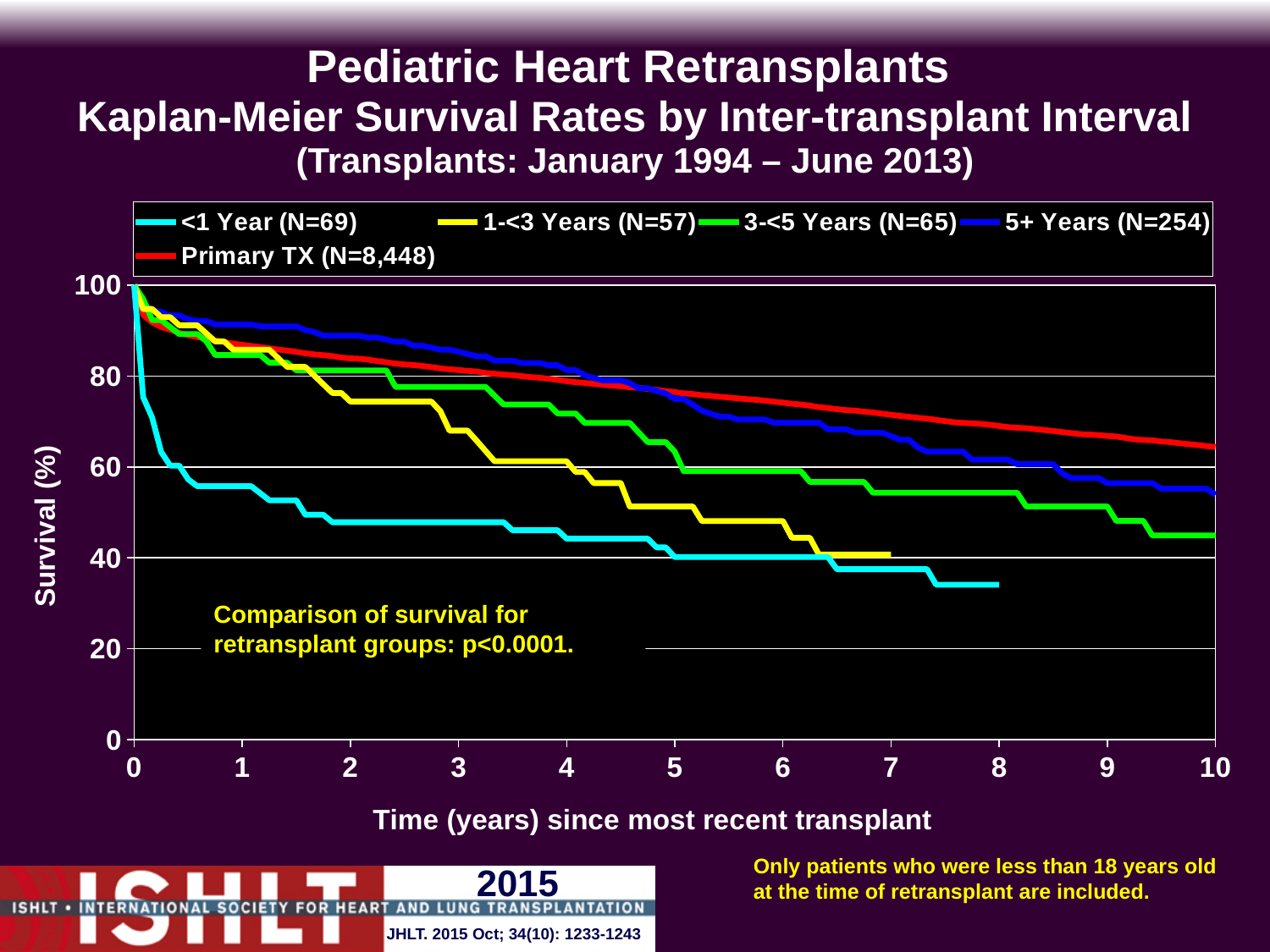
What is the N for the 5+ Years group shown in the legend? 254 What is the N for the <1 Year group shown in the legend? 69 Is the survival for the 5+ Years group at 5 years greater or less than 80? less At 5 years, which group has higher survival: 5+ Years or <1 Year? 5+ Years What kind of chart is shown on the slide? line chart Is the survival for the Primary TX group at 10 years greater or less than 60? greater Which group has the lowest survival curve throughout the chart? <1 Year (N=69) What is the N for the Primary TX group shown in the legend? 8,448 Which group has the highest survival at 10 years? Primary TX (N=8,448) Do the survival curves rise or fall as time since transplant increases? fall Is the survival for the <1 Year group at 8 years greater or less than 40? less How many series does the legend list? 5